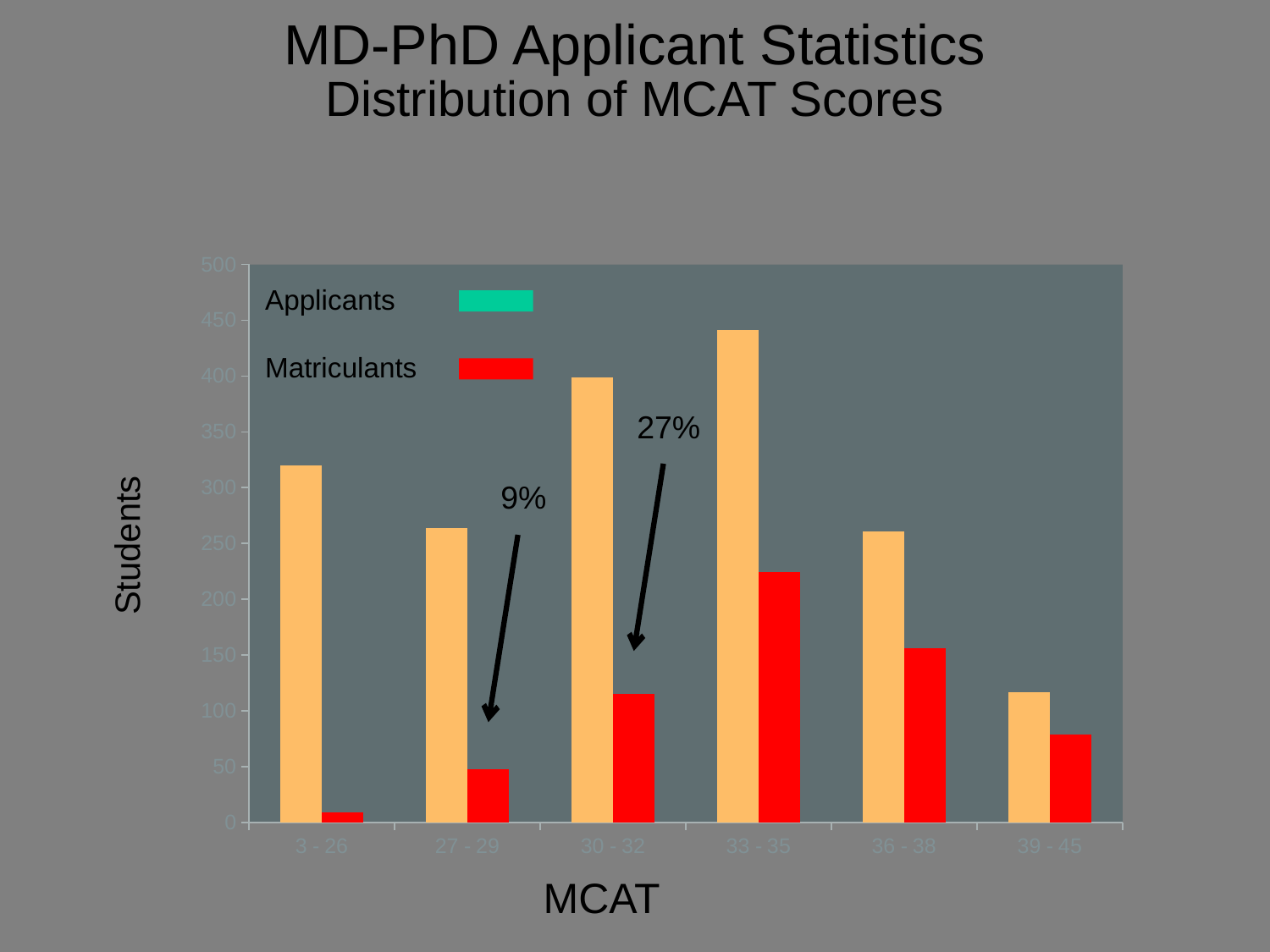
What kind of chart is shown on the slide? bar chart How many MCAT score categories are shown on the x axis? 6 Which MCAT score range has the lowest number of Matriculants? 3 - 26 What is the label on the y axis? Students Is the number of Matriculants in the 27 - 29 range greater or less than 100? less Which MCAT score range has the lowest number of Applicants? 39 - 45 Which MCAT score range has the highest number of Applicants? 33 - 35 Which is larger: the number of Matriculants in the 36 - 38 range or in the 39 - 45 range? 36 - 38 How many series does the legend list? 2 What percentage is annotated above the Matriculants bar for the 30 - 32 range? 27% Which MCAT score range has the highest number of Matriculants? 33 - 35 Is the number of Applicants in the 30 - 32 range greater or less than 350? greater